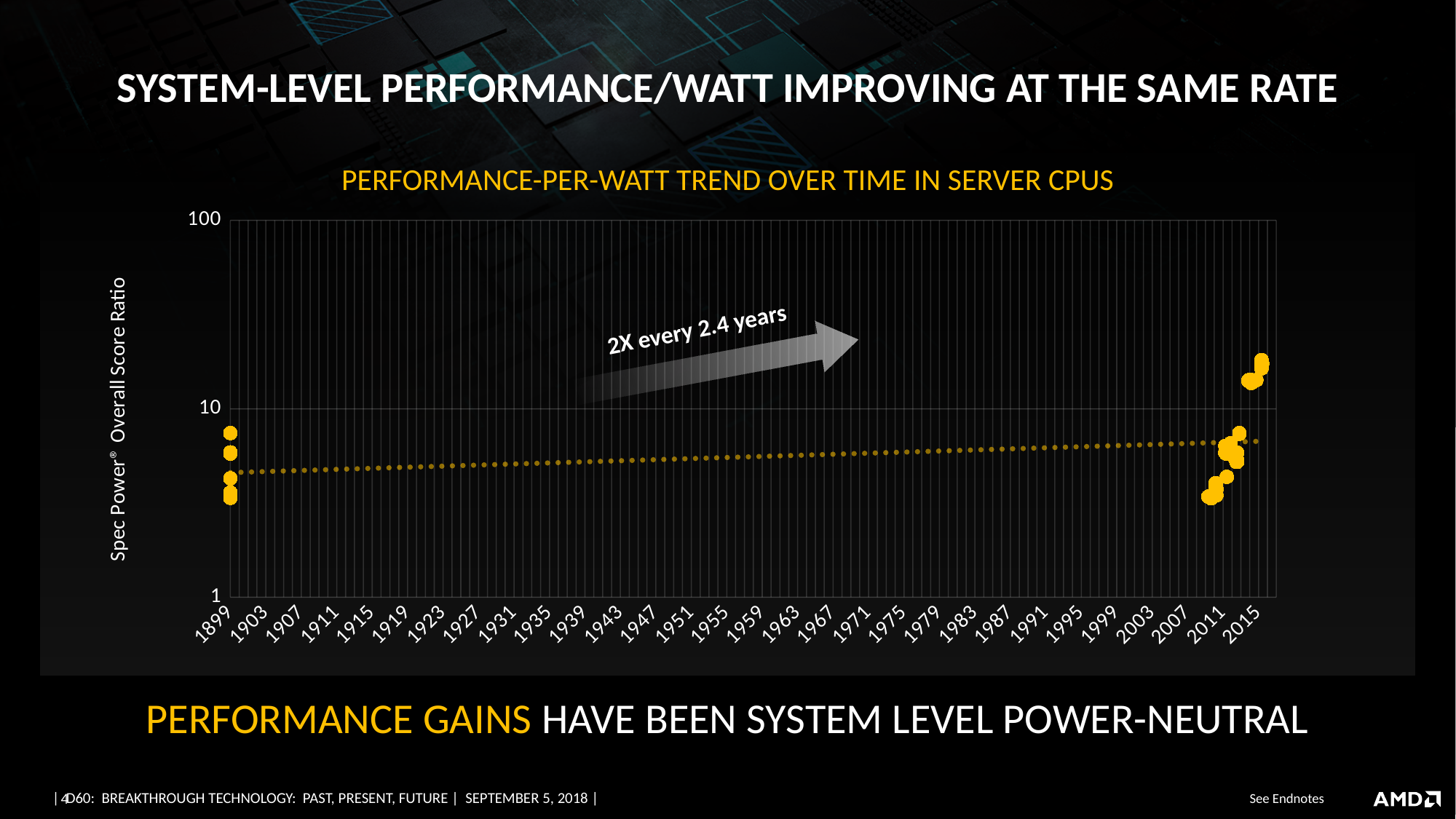
What is the lowest value shown on the y axis? 1 Which cluster of points reaches higher values: the points near 1899 or the points near 2015? The points near 2015 Are the highest data points plotted near 2015 greater or less than 10? greater What rate of improvement does the arrow annotation on the chart state? 2X every 2.4 years What kind of chart is shown on the slide? Scatter chart Does the dotted trend line rise or fall from left to right? Rise What is the last year label on the x axis? 2015 What is the first year label on the x axis? 1899 Are the data points plotted near 1899 greater or less than 10? less What is the title of the chart? Performance-per-watt trend over time in server CPUs What is the label of the y axis? Spec Power Overall Score Ratio What is the highest value shown on the y axis? 100